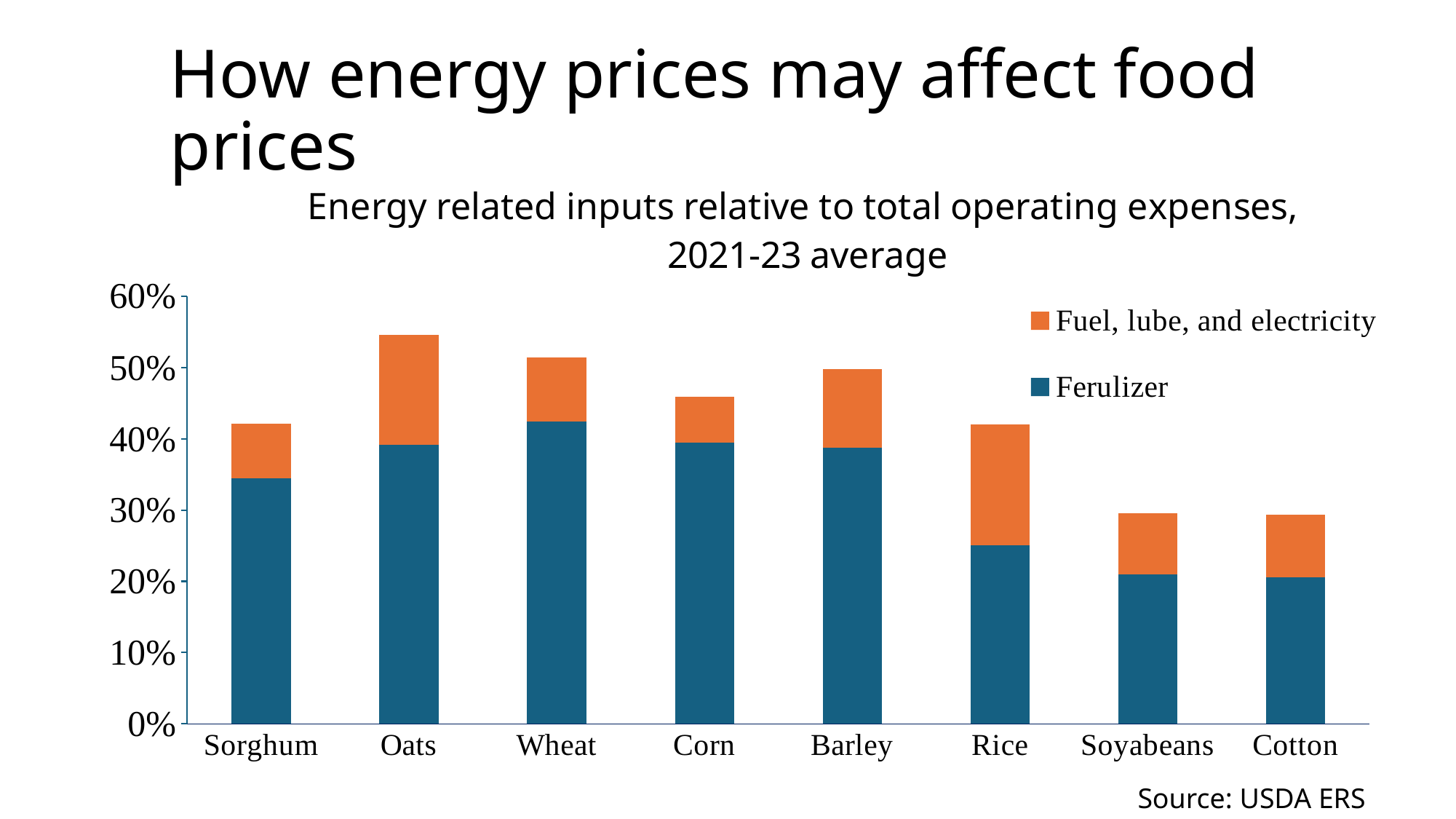
What kind of chart is shown on the slide? Stacked bar chart Is the total stacked bar for Oats greater or less than 50%? greater Which crop has the largest Ferulizer segment? Wheat Which crop has the tallest stacked bar overall? Oats What is the source cited for the chart? USDA ERS Is the Ferulizer value for Wheat greater or less than 40%? greater How many crop categories are shown on the x axis? 8 Which has the larger total stacked bar, Oats or Corn? Oats Is the Ferulizer value for Rice greater or less than 30%? less Which crop has the larger Fuel, lube, and electricity segment, Rice or Sorghum? Rice How many series does the legend list? 2